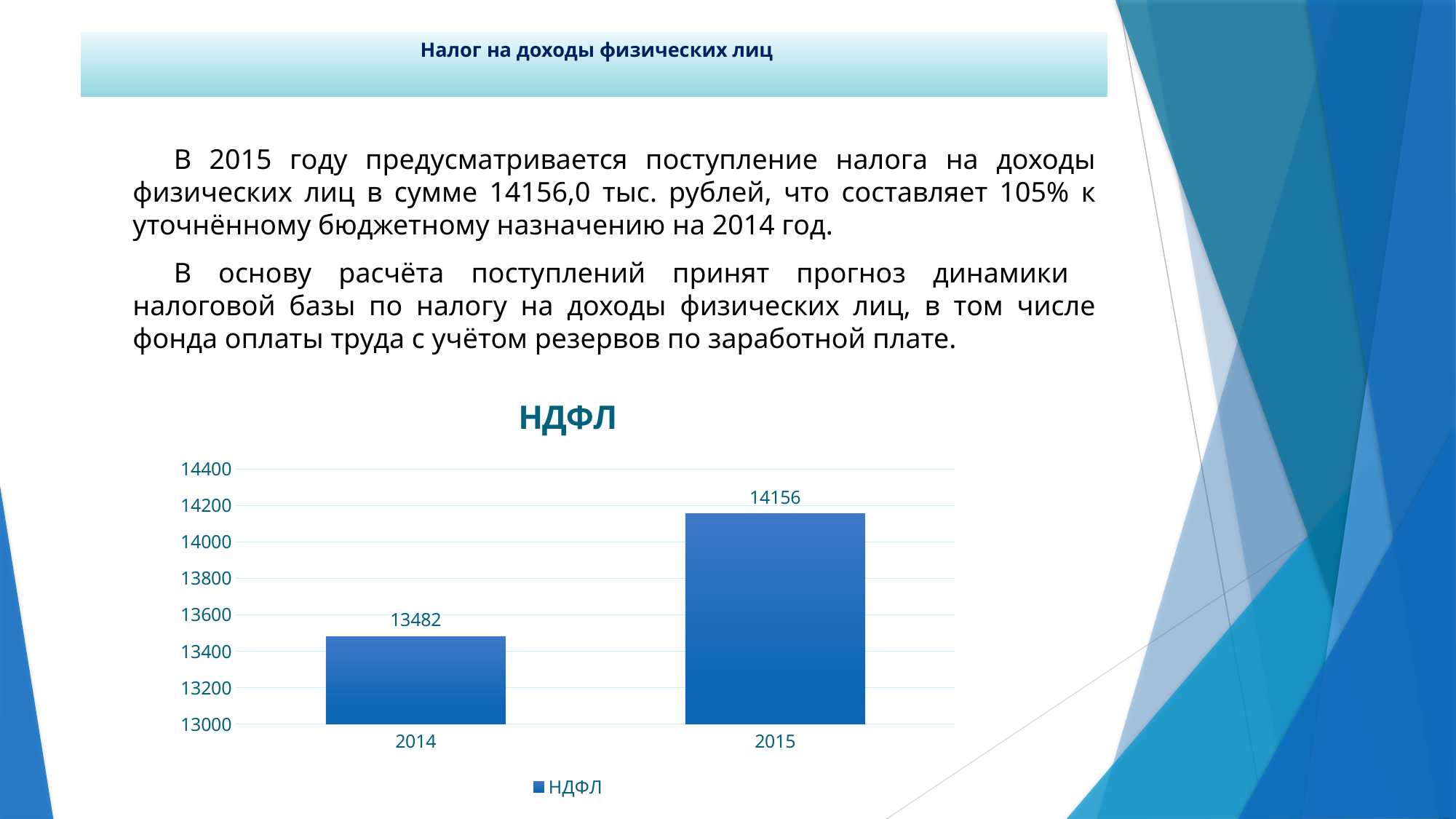
What kind of chart is the НДФЛ chart? bar chart How many years are shown on the x axis of the НДФЛ chart? 2 What is the value for 2015 in the НДФЛ chart? 14156 What is the value for 2014 in the НДФЛ chart? 13482 Which year has the highest value in the НДФЛ chart? 2015 Is the value for 2015 in the НДФЛ chart greater or less than 14000? greater Which is larger in the НДФЛ chart, the value for 2014 or for 2015? 2015 How many series does the legend of the НДФЛ chart list? 1 Do the values in the НДФЛ chart rise or fall from 2014 to 2015? rise Which year has the lowest value in the НДФЛ chart? 2014 What is the difference between the 2015 and 2014 values in the НДФЛ chart? 674 Is the value for 2014 in the НДФЛ chart greater or less than 13600? less